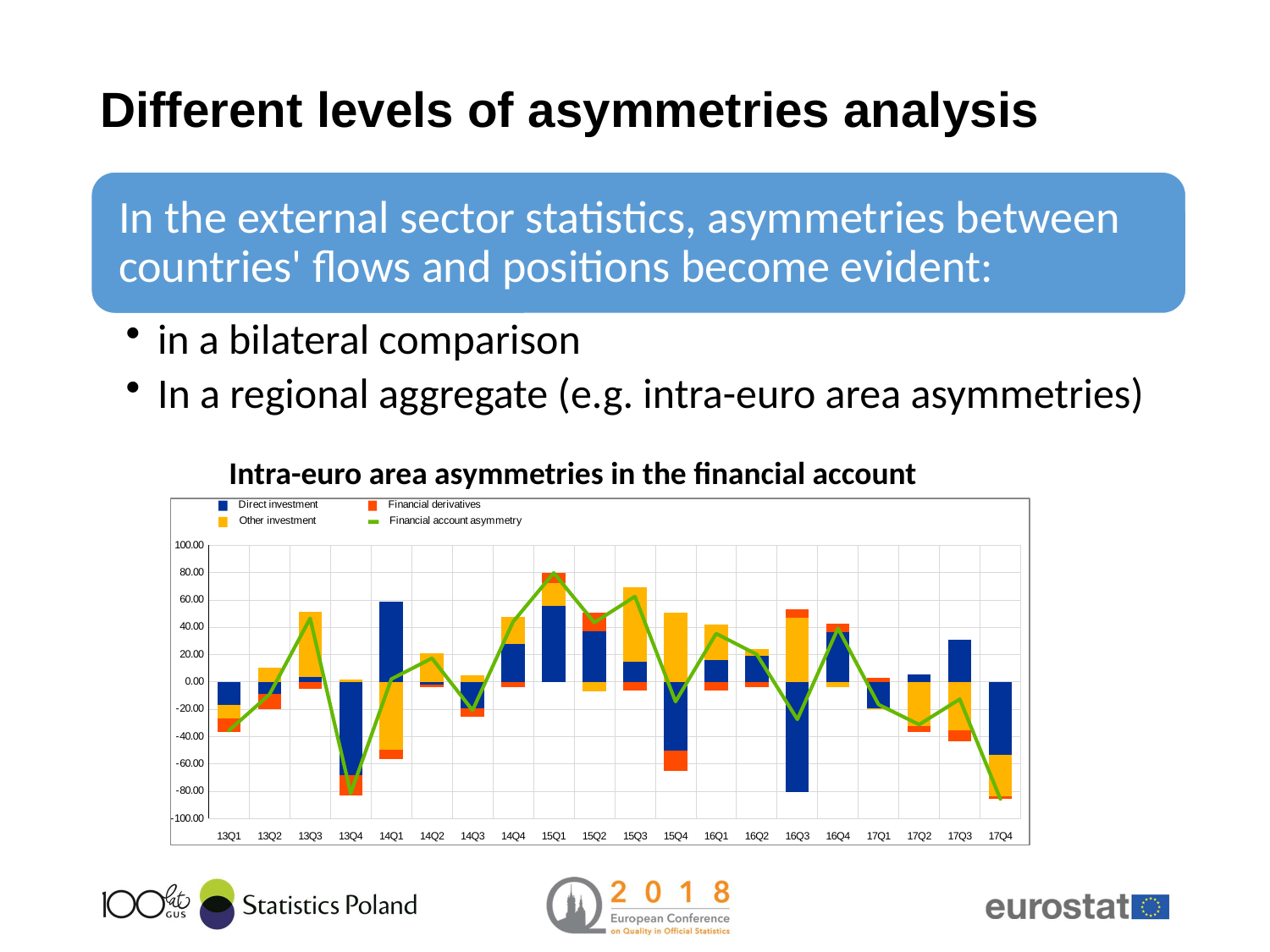
Which series in the chart is drawn as a line? Financial account asymmetry What is the title of the chart on the slide? Intra-euro area asymmetries in the financial account In which quarter does the Financial account asymmetry line reach its lowest value? 17Q4 Is the Financial account asymmetry value for 17Q4 greater or less than -60? less Is the Direct investment value for 14Q1 greater or less than 40? greater How many series does the chart's legend list? 4 In which quarter does the Financial account asymmetry line reach its highest value? 15Q1 What kind of chart is shown on the slide? Stacked bar chart with a line Is the Direct investment value for 16Q3 greater or less than -60? less Which quarter has the larger Financial account asymmetry value, 15Q1 or 15Q3? 15Q1 How many quarters are shown along the x axis of the chart? 20